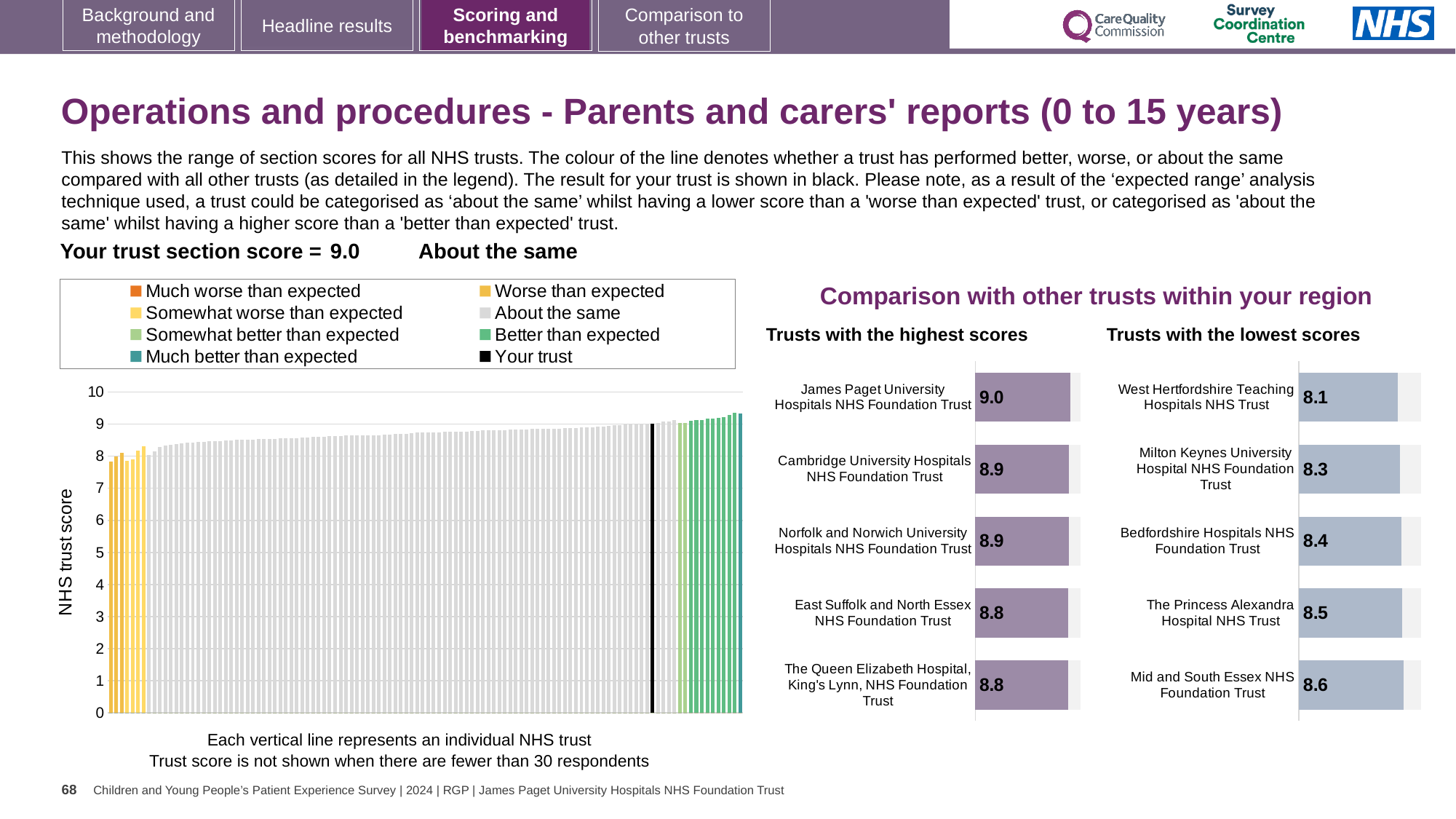
In the 'Trusts with the lowest scores' chart, what is the score for West Hertfordshire Teaching Hospitals NHS Trust? 8.1 In the 'Trusts with the highest scores' chart, what is the difference between the scores of James Paget University Hospitals NHS Foundation Trust and East Suffolk and North Essex NHS Foundation Trust? 0.2 In the 'Trusts with the lowest scores' chart, which has the higher score: Milton Keynes University Hospital NHS Foundation Trust or The Princess Alexandra Hospital NHS Trust? The Princess Alexandra Hospital NHS Trust What kind of chart is the main chart on the left showing NHS trust scores? Bar chart In the main 'NHS trust score' chart, do the bar values rise or fall from left to right along the x axis? Rise In the 'Trusts with the highest scores' chart, which trust has the highest score? James Paget University Hospitals NHS Foundation Trust In the 'Trusts with the lowest scores' chart, what is the score for Bedfordshire Hospitals NHS Foundation Trust? 8.4 In the 'Trusts with the lowest scores' chart, which trust has the lowest score? West Hertfordshire Teaching Hospitals NHS Trust In the 'Trusts with the highest scores' chart, what is the score for James Paget University Hospitals NHS Foundation Trust? 9.0 How many entries does the legend of the main 'NHS trust score' chart list? 8 In the 'Trusts with the lowest scores' chart, what is the difference between the scores of Mid and South Essex NHS Foundation Trust and West Hertfordshire Teaching Hospitals NHS Trust? 0.5 How many trusts are shown in the 'Trusts with the highest scores' chart? 5